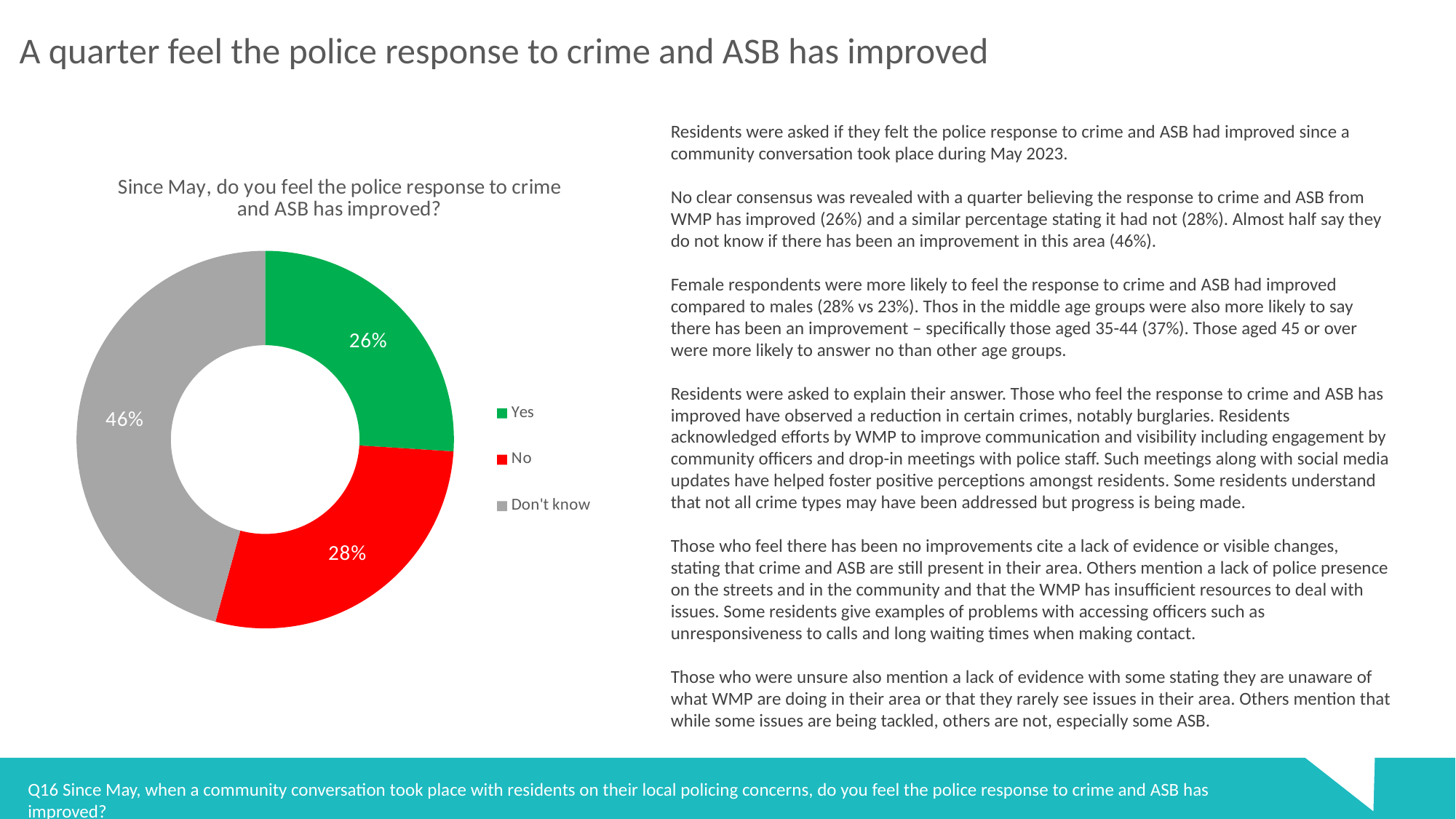
Which is larger, the share for 'Don't know' or the share for 'Yes'? Don't know How many response categories are shown in the chart? 3 What colour represents the 'No' response in the chart? Red Which response has the smallest share of the chart? Yes What percentage of respondents answered 'Don't know'? 46% What is the title of the chart? Since May, do you feel the police response to crime and ASB has improved? What is the difference in percentage points between 'No' and 'Yes'? 2 What kind of chart is shown on the slide? Pie chart (doughnut) Which response has the largest share of the chart? Don't know What percentage of respondents answered 'No'? 28% What is the difference in percentage points between 'Don't know' and 'No'? 18 What percentage of respondents answered 'Yes'? 26%